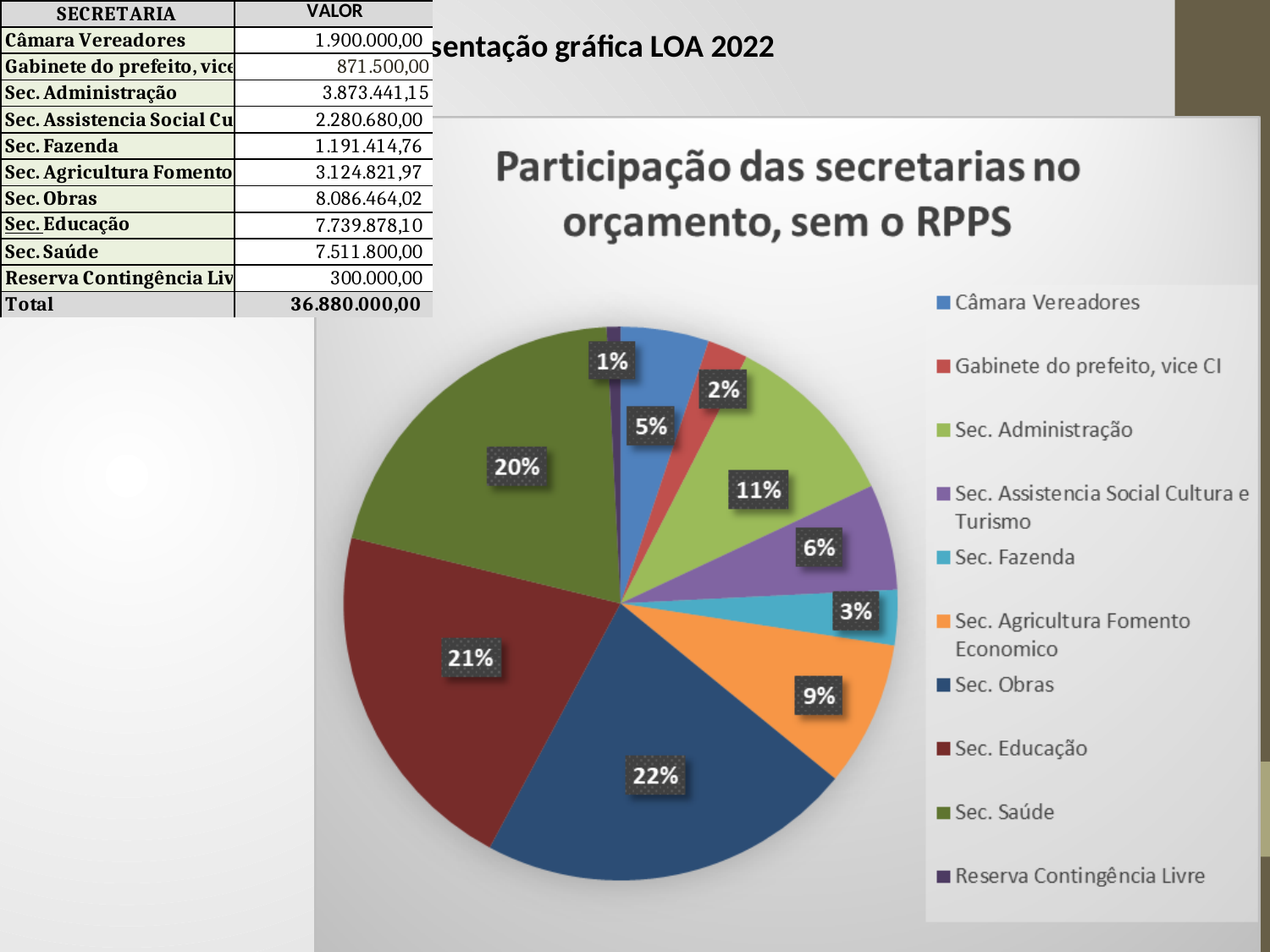
What share of the pie does Sec. Saúde have? 20% Which category has the smallest slice of the pie? Reserva Contingência Livre What share of the pie does Sec. Educação have? 21% What share of the pie does Sec. Administração have? 11% Which category has the largest slice of the pie? Sec. Obras What kind of chart is shown on the slide? pie chart What is the title of the pie chart? Participação das secretarias no orçamento, sem o RPPS Which has a larger share of the pie, Sec. Agricultura Fomento Economico or Sec. Assistencia Social Cultura e Turismo? Sec. Agricultura Fomento Economico How many categories does the legend of the pie chart list? 10 What is the difference in percentage points between the shares of Sec. Obras and Câmara Vereadores? 17